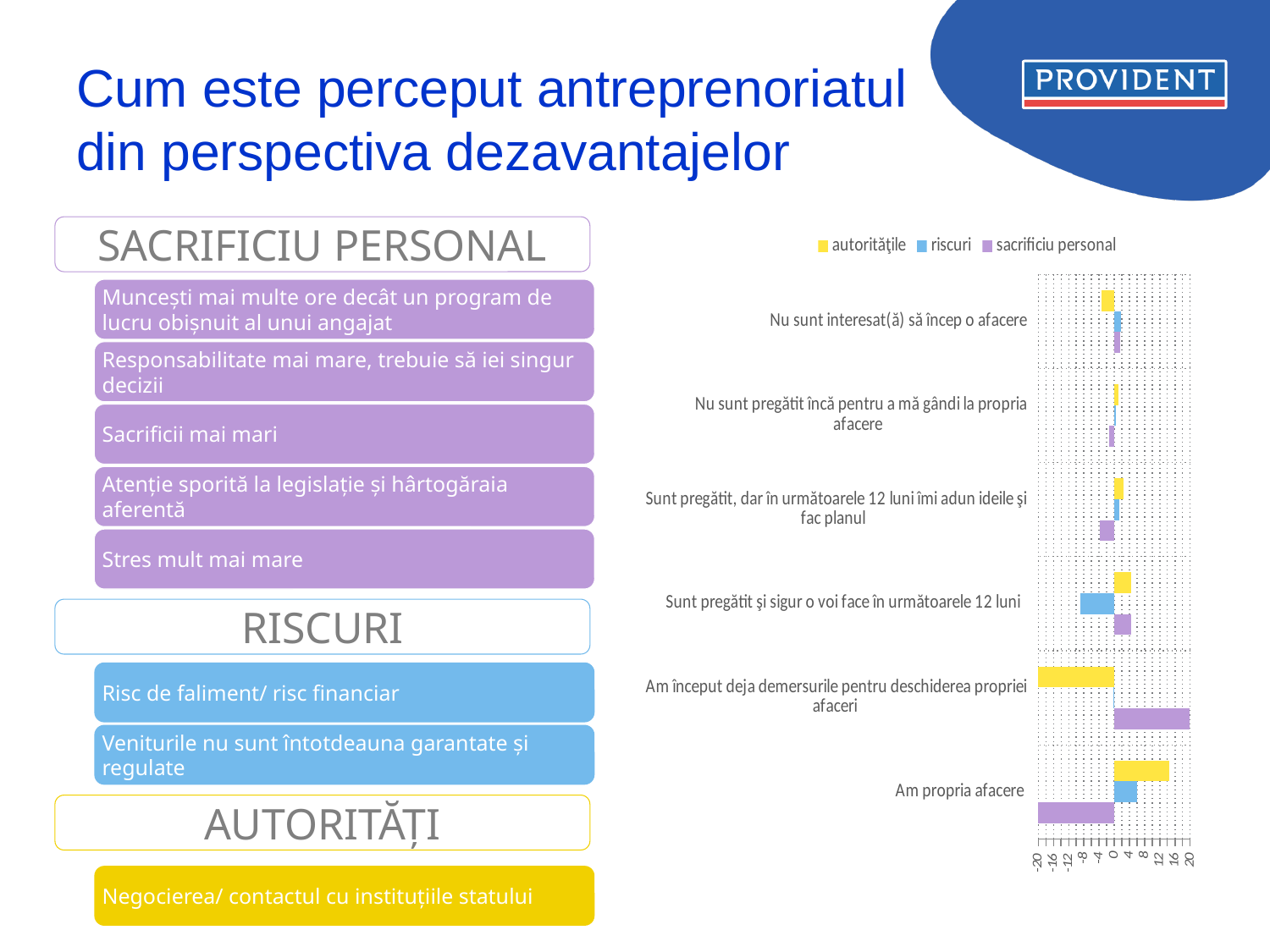
Which category has the lowest value for the autoritățile series? Am început deja demersurile pentru deschiderea propriei afaceri Which category has the highest value for the autoritățile series? Am propria afacere Is the sacrificiu personal value for 'Am propria afacere' greater or less than -12? less What kind of chart is shown on the right side of the slide? bar chart Which category has the lowest value for the riscuri series? Sunt pregătit și sigur o voi face în următoarele 12 luni How many categories are plotted on the chart? 6 Which category has the lowest value for the sacrificiu personal series? Am propria afacere For 'Am propria afacere', which series has the larger value: autoritățile or riscuri? autoritățile Which category has the highest value for the sacrificiu personal series? Am început deja demersurile pentru deschiderea propriei afaceri Is the autoritățile value for 'Am propria afacere' greater or less than 8? greater Is the autoritățile value for 'Am început deja demersurile pentru deschiderea propriei afaceri' greater or less than -12? less How many series does the chart legend list? 3